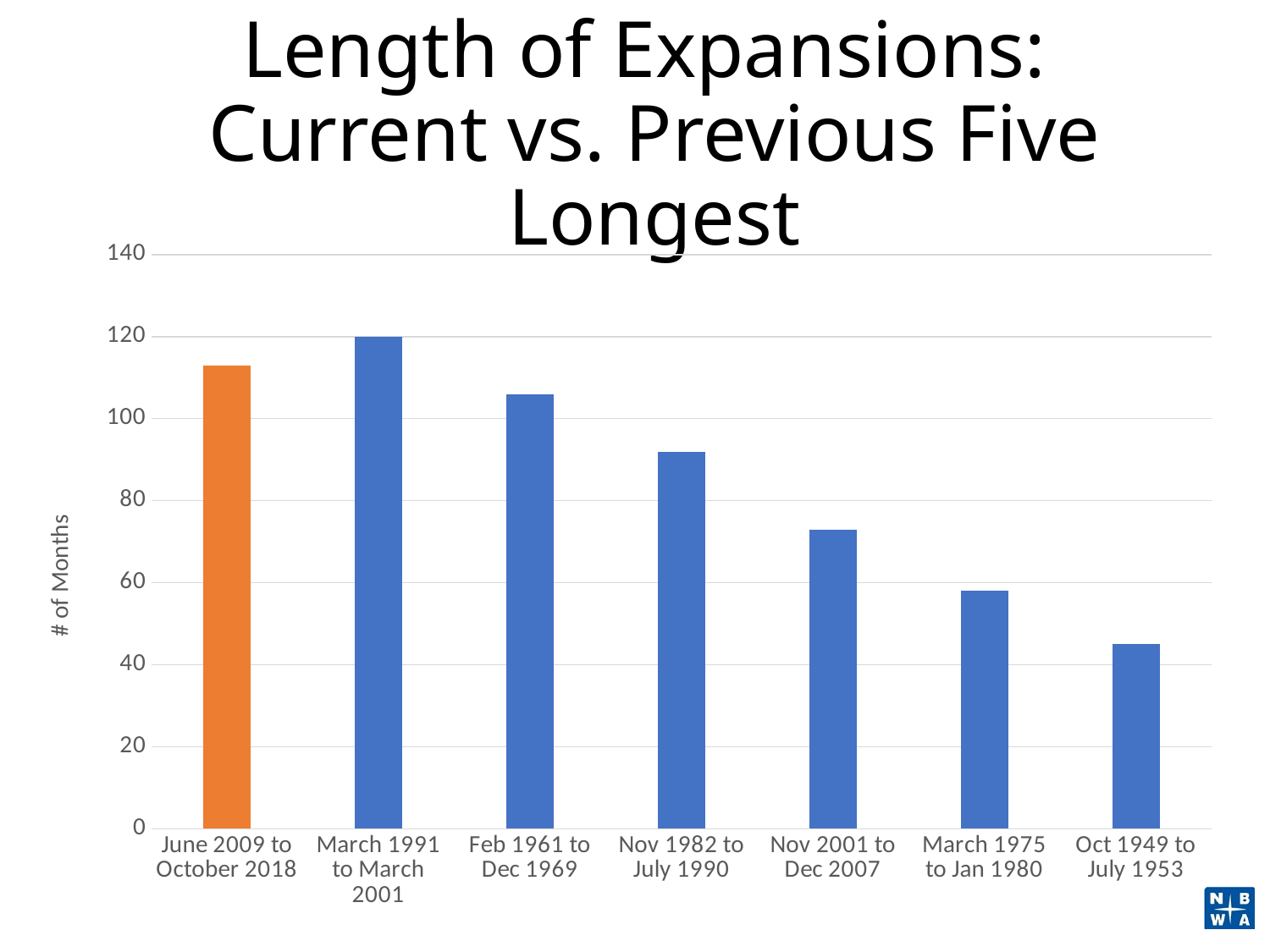
Which expansion period has the lowest number of months? Oct 1949 to July 1953 Is the value for Nov 1982 to July 1990 greater or less than 100? less Which expansion period is shown with an orange bar? June 2009 to October 2018 What is the number of months for the March 1991 to March 2001 expansion? 120 What kind of chart is shown on the slide? bar chart Which expansion period has the highest number of months? March 1991 to March 2001 Is the value for June 2009 to October 2018 greater or less than 100? greater Is the value for Nov 2001 to Dec 2007 greater or less than 80? less Moving from March 1991 to March 2001 rightward along the x axis, do the values rise or fall? fall How many expansion periods are plotted on the chart? 7 Which is larger: the value for June 2009 to October 2018 or the value for Feb 1961 to Dec 1969? June 2009 to October 2018